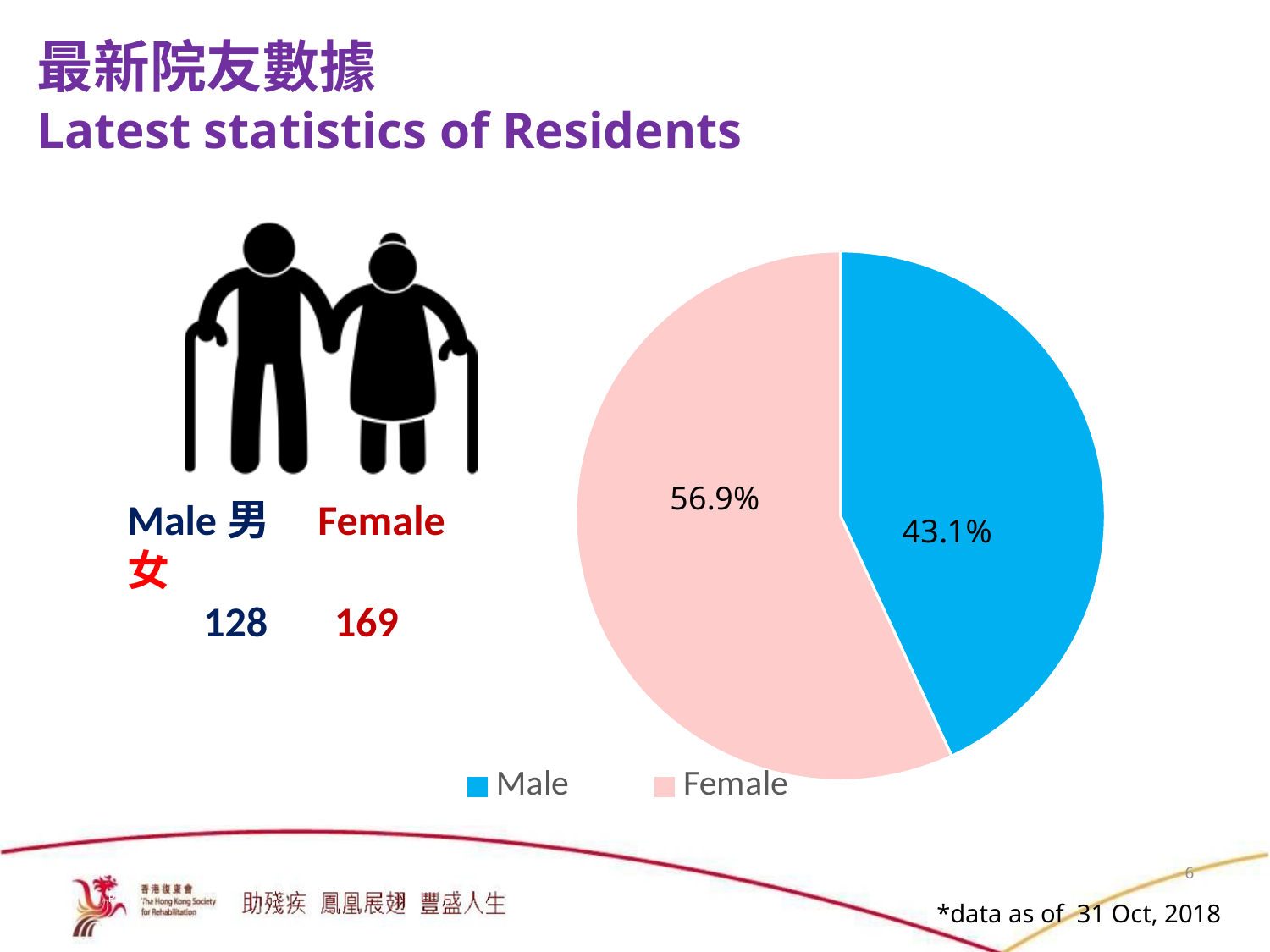
Which slice of the pie chart is the smallest? Male What colour is the Male slice in the pie chart? blue What percentage of the pie chart does the Male slice represent? 43.1% Which is larger in the pie chart, the Male slice or the Female slice? Female How many slices does the pie chart have? 2 What percentage of the pie chart does the Female slice represent? 56.9% Which slice of the pie chart is the largest? Female Is the Female share of the pie chart greater or less than 50%? greater What is the difference in percentage points between the Female and Male slices of the pie chart? 13.8 How many entries does the pie chart legend list? 2 What colour is the Female slice in the pie chart? pink What type of chart is shown on the slide? pie chart